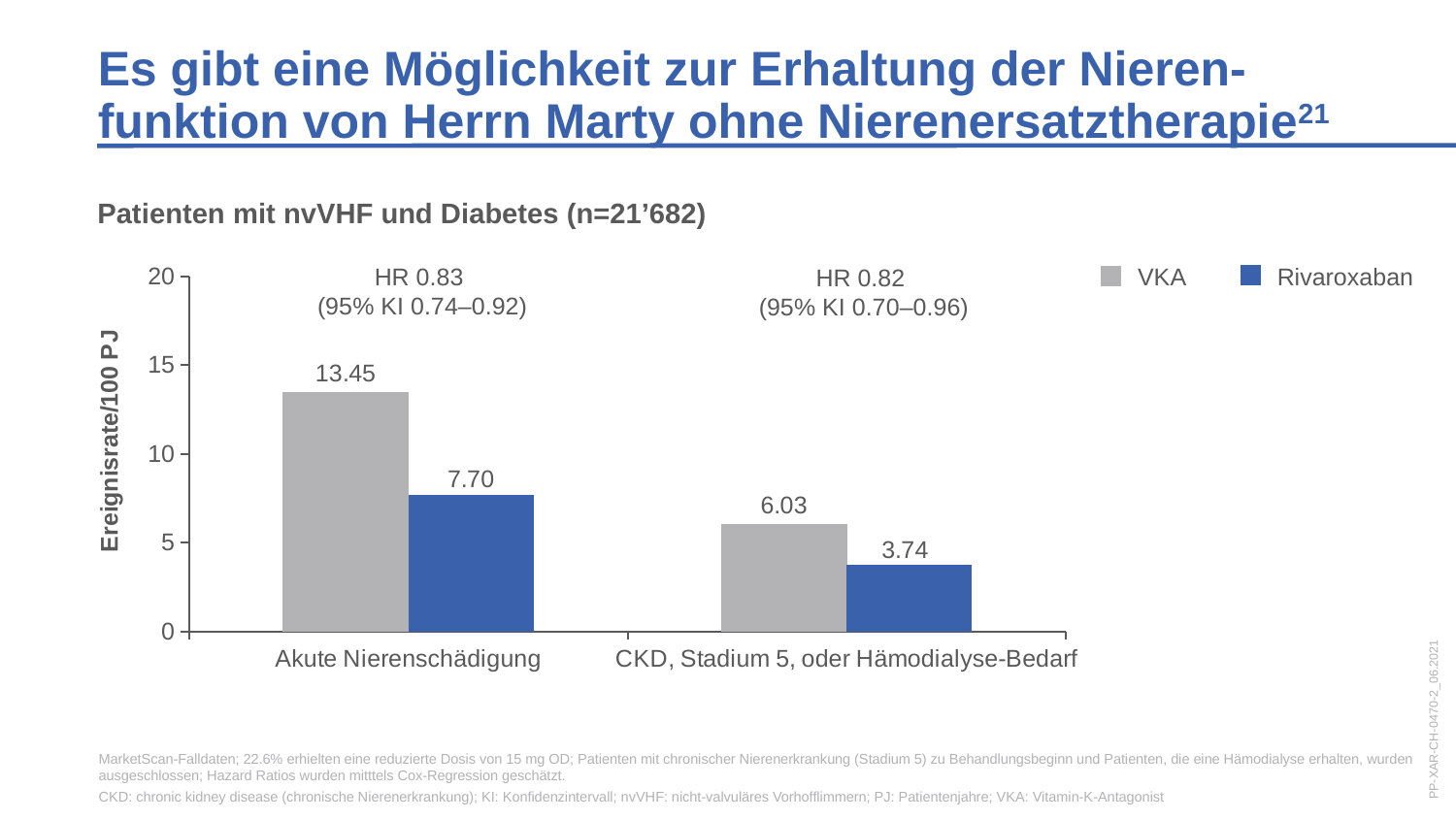
What is the difference between the VKA and Rivaroxaban values for Akute Nierenschädigung? 5.75 What is the event rate for Rivaroxaban in the Akute Nierenschädigung category? 7.70 What is the difference between the VKA and Rivaroxaban values for CKD, Stadium 5, oder Hämodialyse-Bedarf? 2.29 Which bar has the highest value in the chart? VKA, Akute Nierenschädigung What kind of chart is shown on the slide? Bar chart What is the label of the y axis? Ereignisrate/100 PJ Which bar has the lowest value in the chart? Rivaroxaban, CKD, Stadium 5, oder Hämodialyse-Bedarf Which is larger: the Rivaroxaban value for Akute Nierenschädigung or the VKA value for CKD, Stadium 5, oder Hämodialyse-Bedarf? Rivaroxaban value for Akute Nierenschädigung What is the event rate for VKA in the Akute Nierenschädigung category? 13.45 What is the event rate for VKA in the CKD, Stadium 5, oder Hämodialyse-Bedarf category? 6.03 What is the event rate for Rivaroxaban in the CKD, Stadium 5, oder Hämodialyse-Bedarf category? 3.74 How many series does the legend list? 2